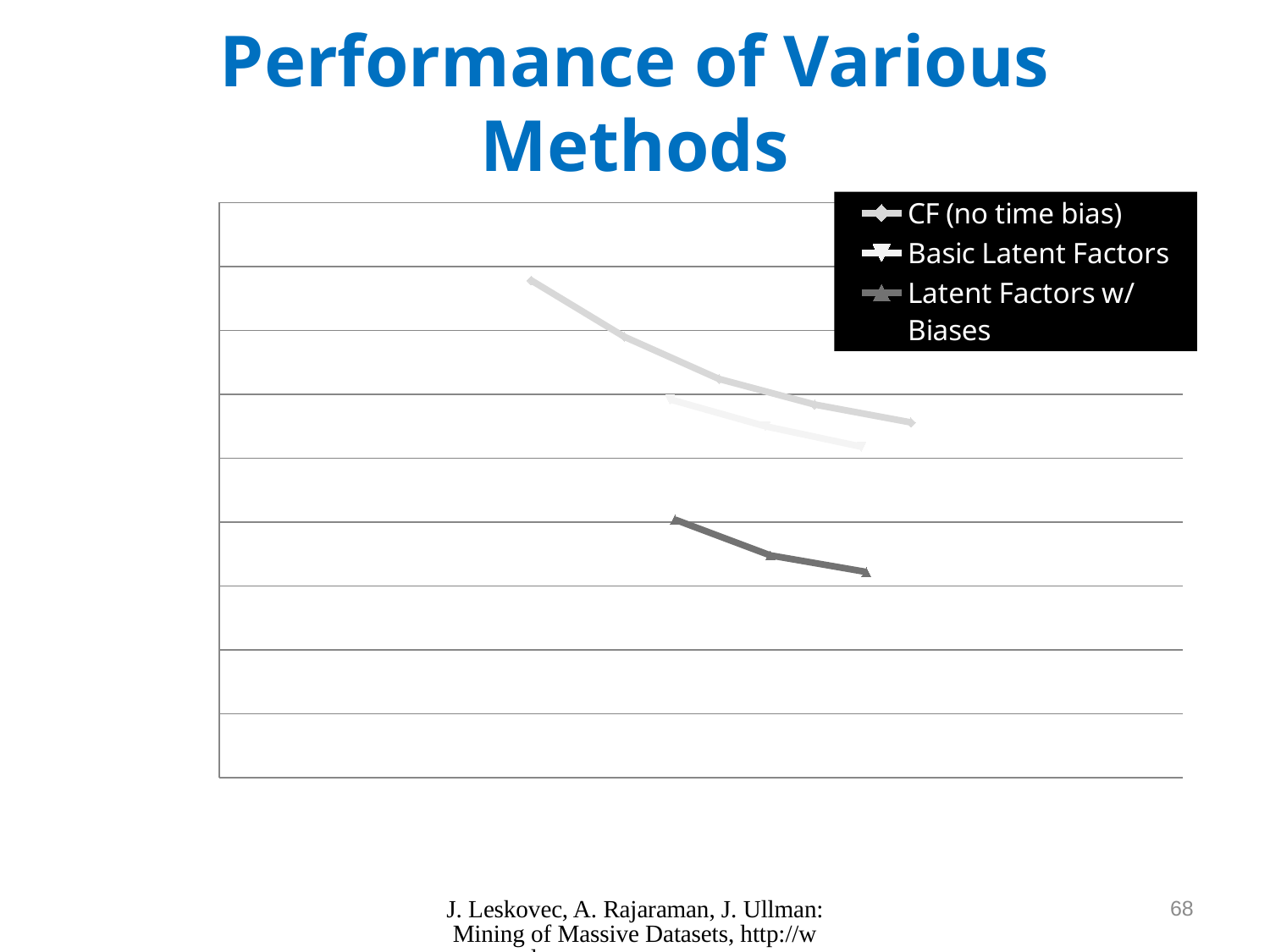
Do the values of the Latent Factors w/ Biases series rise or fall from left to right? fall How many data points are plotted for the Latent Factors w/ Biases series? 3 Which series is plotted lowest on the chart? Latent Factors w/ Biases What is the title of the slide containing the chart? Performance of Various Methods Which series is plotted highest on the chart? CF (no time bias) What kind of chart is shown on the slide? line chart Which series is plotted higher on the chart, CF (no time bias) or Latent Factors w/ Biases? CF (no time bias) Do the values of the Basic Latent Factors series rise or fall from left to right? fall How many series does the legend list? 3 Which series is listed first in the legend? CF (no time bias) Do the values of the CF (no time bias) series rise or fall from left to right? fall